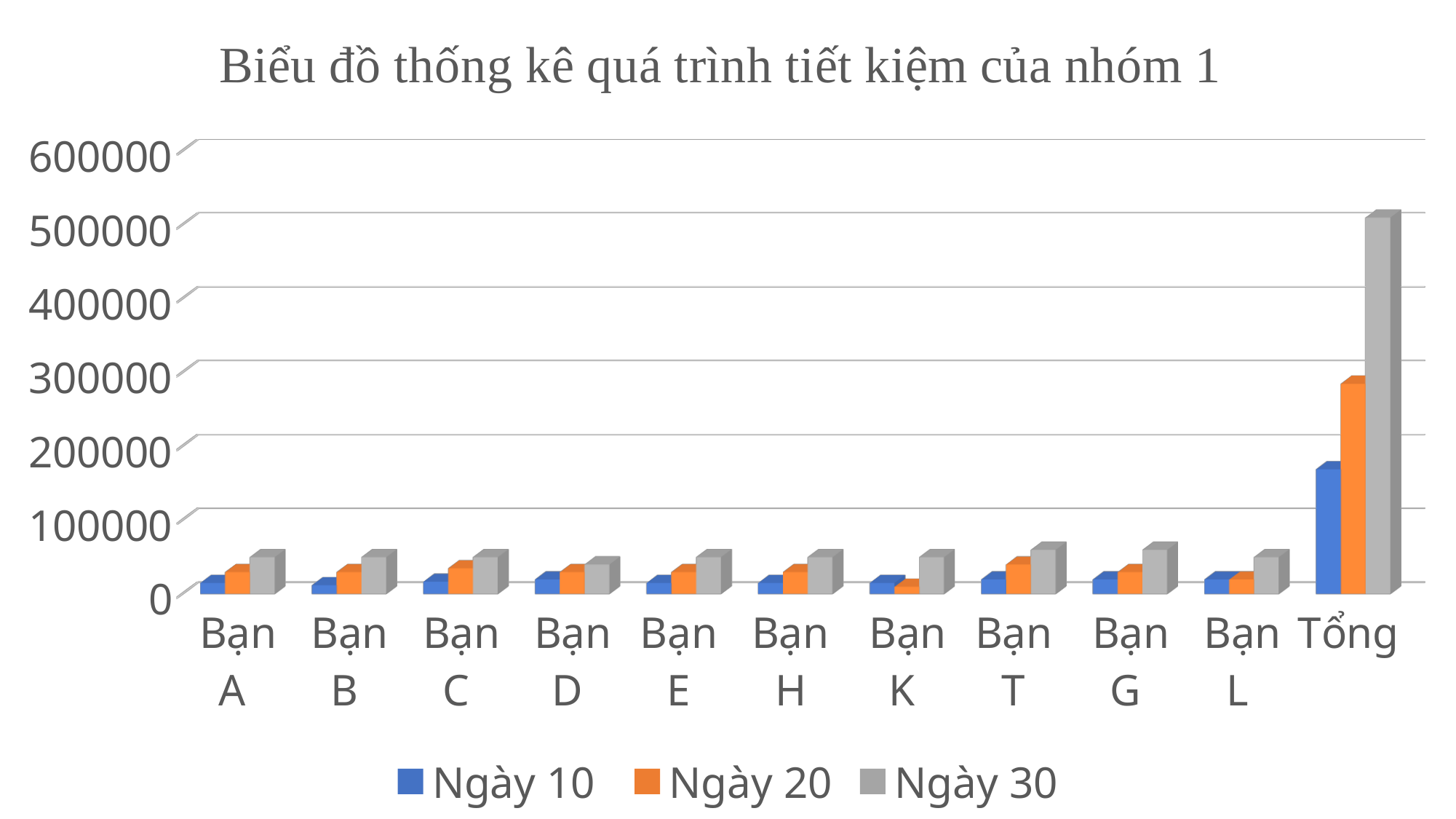
Which category has the highest value for the Ngày 30 series? Tổng Is the Ngày 10 value for Tổng greater or less than 200000? less How many series does the legend list? 3 How many categories are shown on the x axis? 11 What kind of chart is shown on the slide? Bar chart For Tổng, which is larger: the Ngày 10 value or the Ngày 30 value? Ngày 30 Which category has the lowest value for the Ngày 20 series? Bạn K Which series is shown in orange according to the legend? Ngày 20 What is the title of the chart? Biểu đồ thống kê quá trình tiết kiệm của nhóm 1 Is the Ngày 30 value for Bạn A greater or less than 100000? less Is the Ngày 30 value for Tổng greater or less than 400000? greater